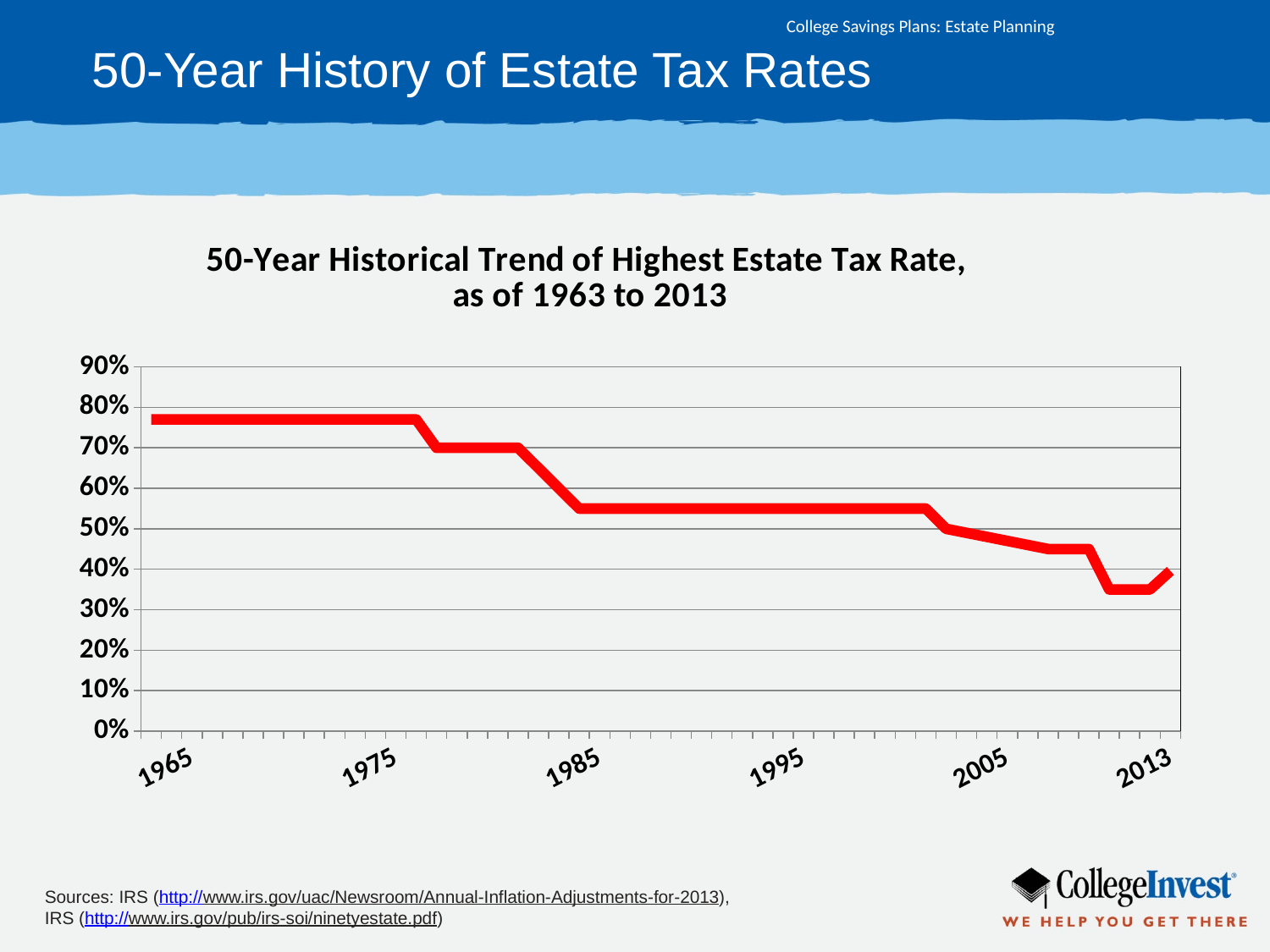
Is the value for 1965 greater or less than 70%? greater Of the years labeled on the x axis, which has the lowest value? 2013 What kind of chart is shown on the slide? line chart What is the title of the chart? 50-Year Historical Trend of Highest Estate Tax Rate, as of 1963 to 2013 Is the value for 1985 greater or less than 60%? less Is the value for 1975 greater or less than 70%? greater Overall, does the highest estate tax rate rise or fall from 1965 to 2013? fall Which is larger, the value for 1965 or the value for 2013? 1965